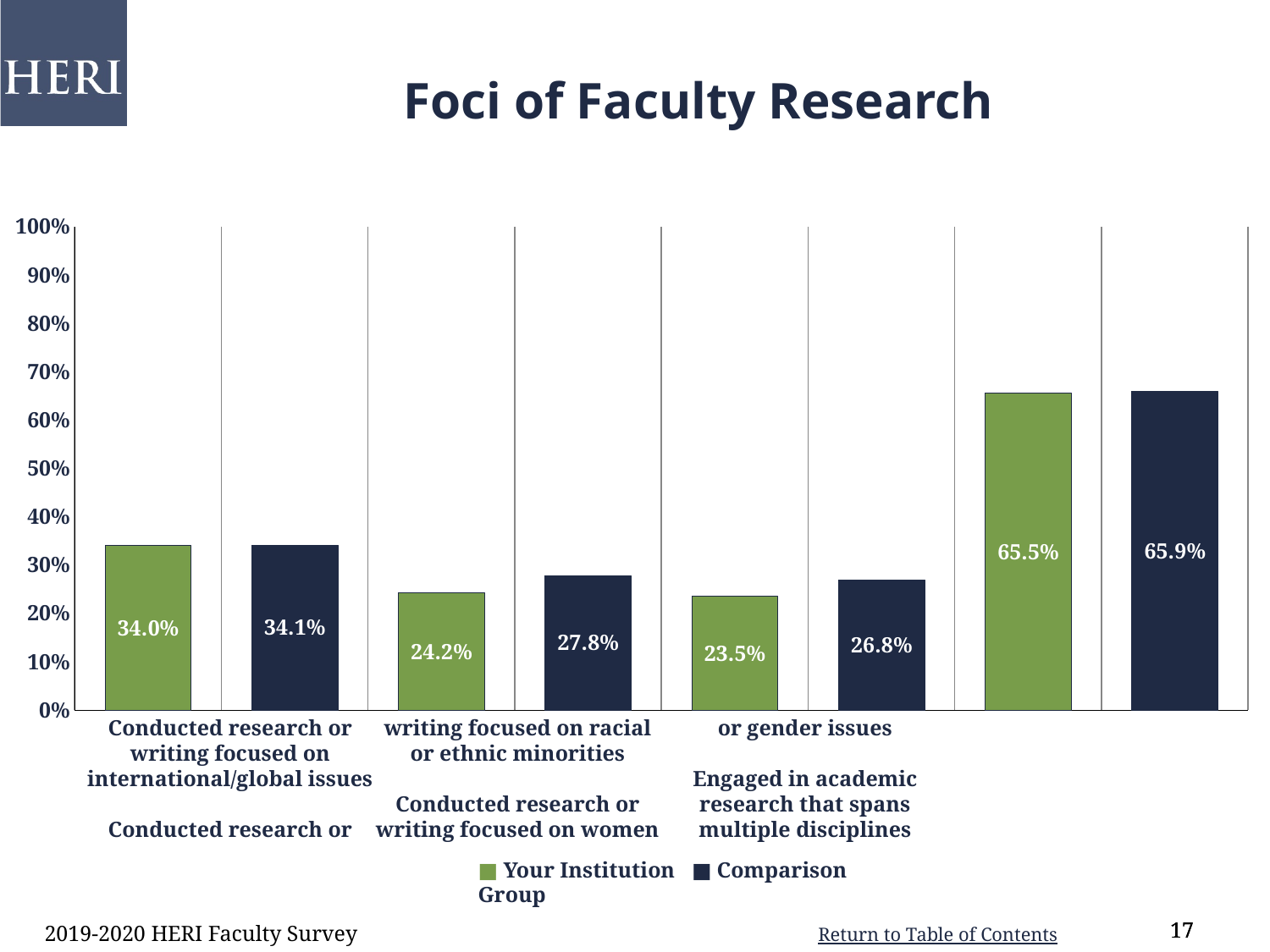
How many series does the legend list? 2 How many categories are shown on the chart? 4 What is the difference between the Comparison Group and Your Institution values for 'Conducted research or writing focused on racial or ethnic minorities'? 3.6% What is the Comparison Group value for 'Conducted research or writing focused on racial or ethnic minorities'? 27.8% What is the Comparison Group value for 'Conducted research or writing focused on international/global issues'? 34.1% Is the Your Institution value for 'Engaged in academic research that spans multiple disciplines' greater or less than 50%? greater For 'Conducted research or writing focused on women or gender issues', which is larger: Your Institution or Comparison Group? Comparison Group What is the value for Your Institution for 'Engaged in academic research that spans multiple disciplines'? 65.5% What kind of chart is shown on the slide? Bar chart Which category has the highest Your Institution value? Engaged in academic research that spans multiple disciplines What is the Your Institution value for 'Conducted research or writing focused on women or gender issues'? 23.5% Which category has the lowest Comparison Group value? Conducted research or writing focused on women or gender issues